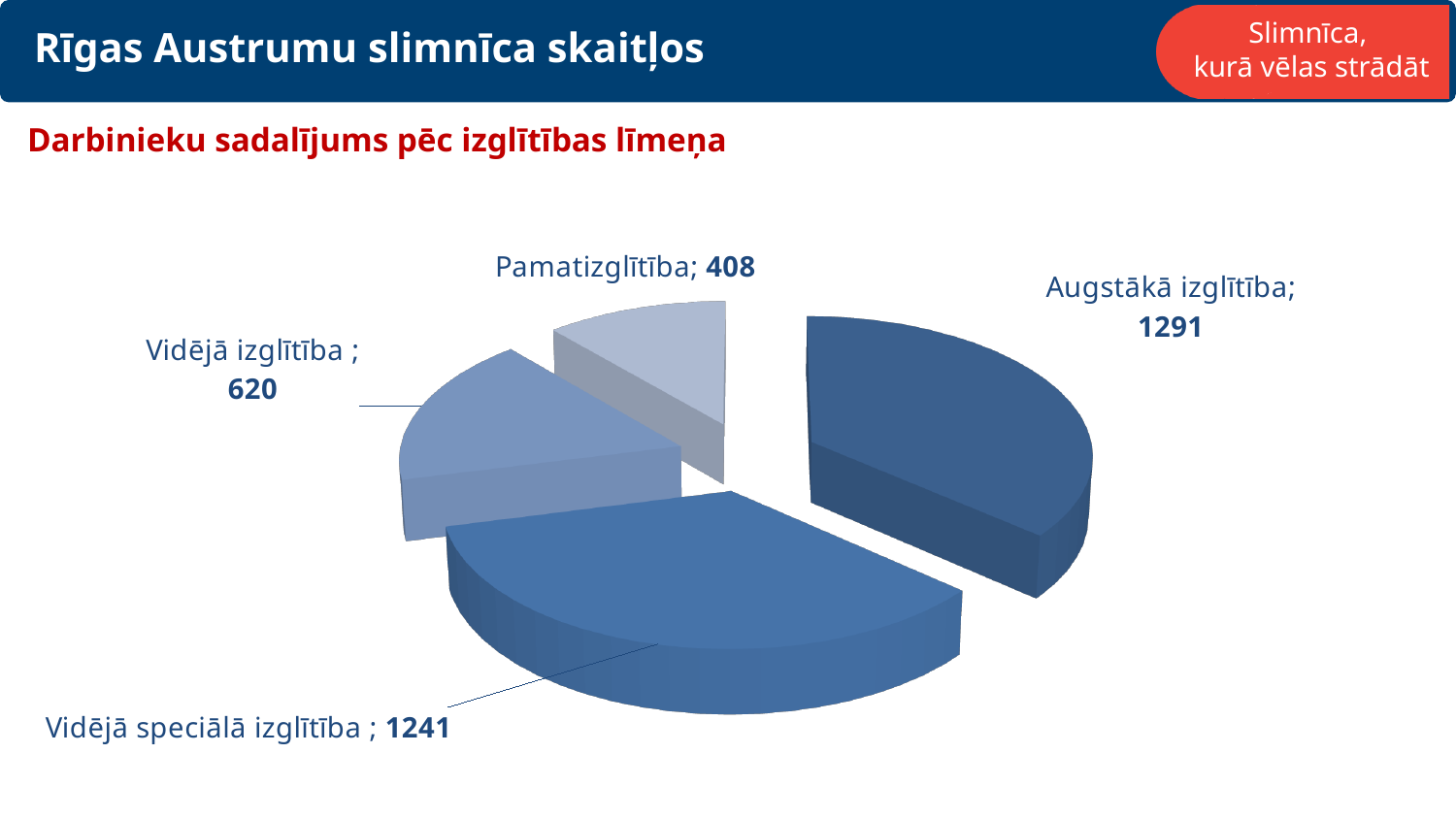
How many slices does the pie chart have? 4 What kind of chart is shown on the slide? Pie chart Which category has the smallest value? Pamatizglītība What is the difference between the values for Augstākā izglītība and Vidējā speciālā izglītība? 50 What is the value for Augstākā izglītība? 1291 What is the difference between the values for Vidējā izglītība and Pamatizglītība? 212 What is the value for Pamatizglītība? 408 Which category has the largest value? Augstākā izglītība What is the title of the chart? Darbinieku sadalījums pēc izglītības līmeņa Which is larger, the value for Vidējā izglītība or the value for Pamatizglītība? Vidējā izglītība What is the value for Vidējā speciālā izglītība? 1241 What is the value for Vidējā izglītība? 620